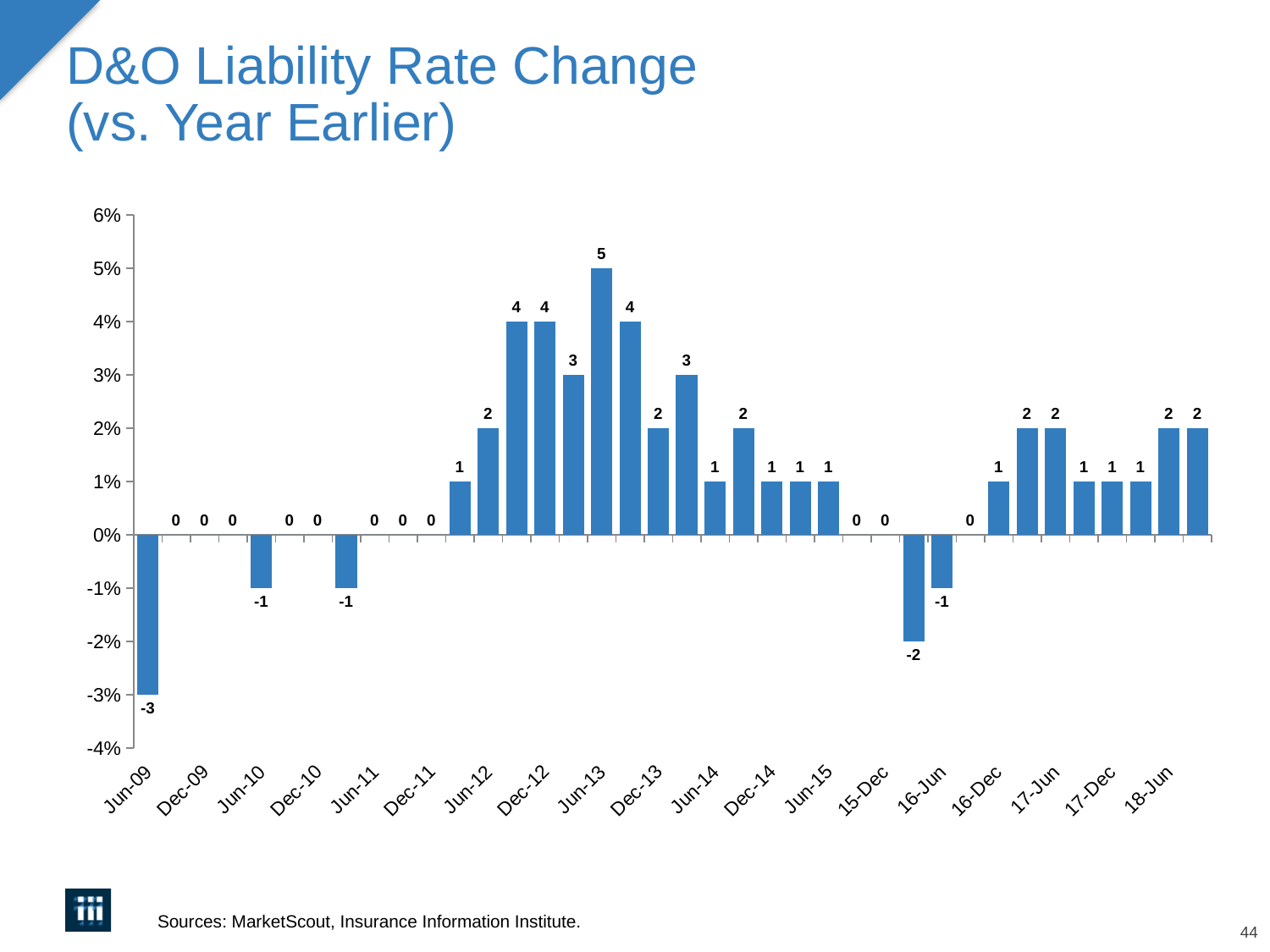
What is the D&O liability rate change value labeled for Jun-10? -1 What is the title of the chart? D&O Liability Rate Change (vs. Year Earlier) What is the D&O liability rate change value labeled for Jun-13? 5 Which period has the highest D&O liability rate change? Jun-13 What is the D&O liability rate change value labeled for Jun-09? -3 What is the highest value labeled on any bar in the chart? 5 What sources are cited for the chart? MarketScout, Insurance Information Institute Which is larger, the value for Jun-12 or the value for Dec-12? Dec-12 What is the difference between the highest bar value (5) and the lowest bar value (-3)? 8 What type of chart is shown on the slide? bar chart Do the values rise or fall from Jun-12 to Jun-13? rise Which period has the lowest D&O liability rate change? Jun-09